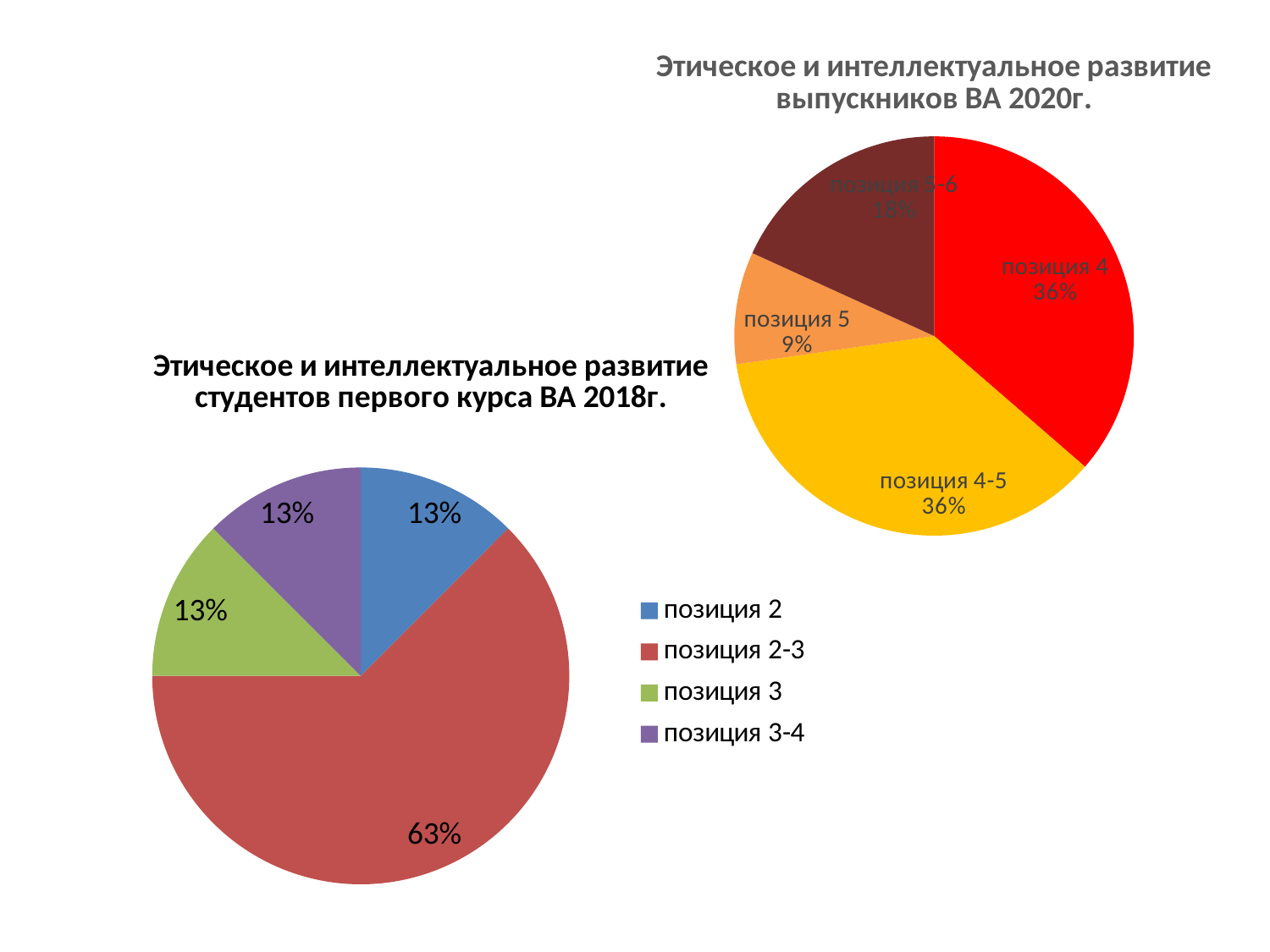
In the 2020 graduates chart, what share does позиция 4 have? 36% How many slices does the 2020 graduates pie chart have? 4 In the 2018 first-year students chart, what is the difference between the shares of позиция 2-3 and позиция 3? 50 percentage points In the 2020 graduates chart, which is larger: позиция 4-5 or позиция 5? позиция 4-5 What kind of chart is the 2018 first-year students chart on the left? pie chart In the 2020 graduates chart, which category has the smallest share? позиция 5 How many categories does the legend of the 2018 first-year students chart list? 4 In the 2018 first-year students chart, what share does позиция 2-3 have? 63% In the 2020 graduates chart, what share does позиция 5 have? 9% In the 2018 first-year students chart, what colour is the slice for позиция 3-4? purple What is the title of the chart on the right? Этическое и интеллектуальное развитие выпускников ВА 2020г. In the 2018 first-year students chart, which category has the largest share? позиция 2-3